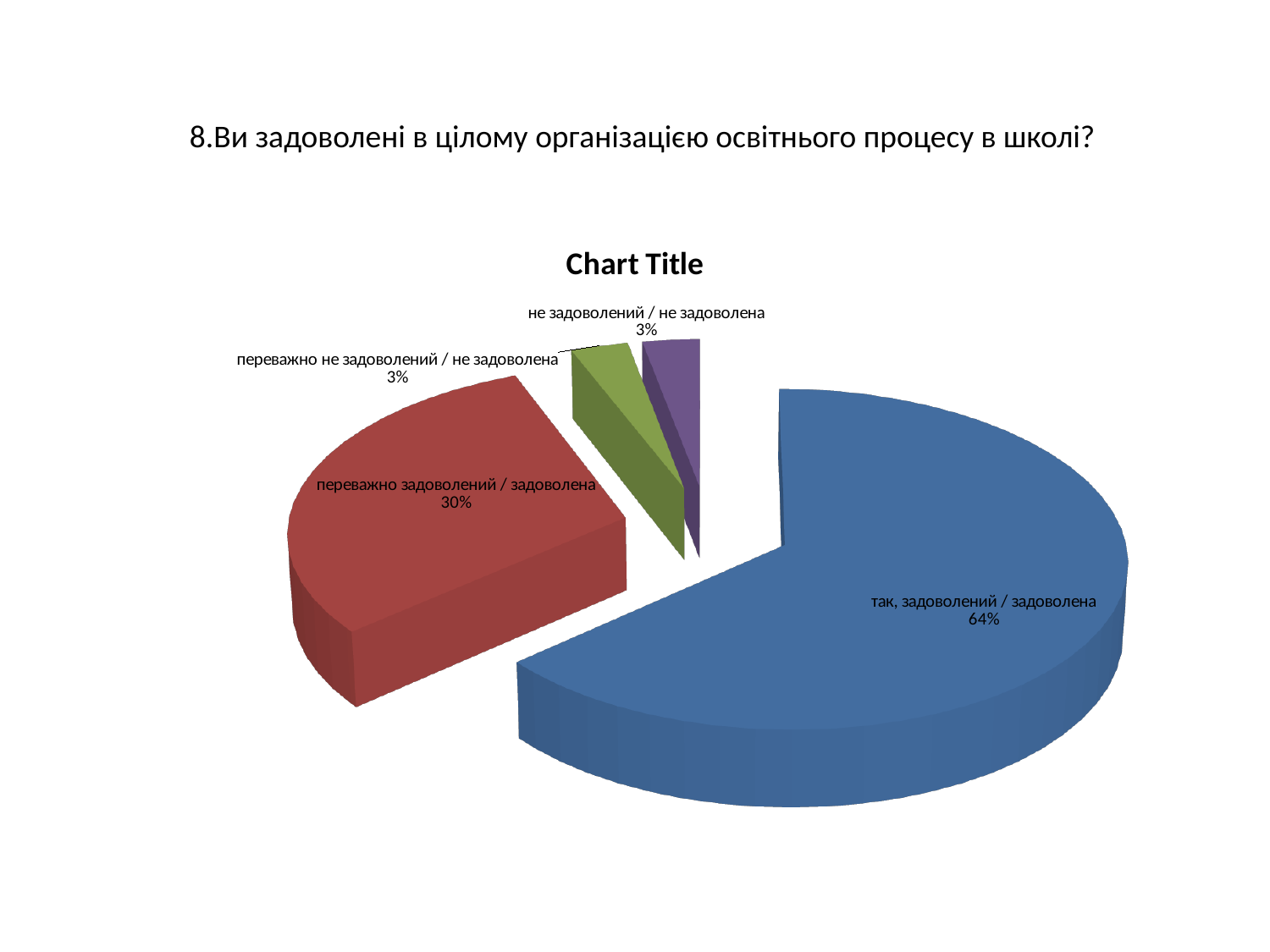
What is the title printed above the pie chart? Chart Title What is the difference in percentage points between "так, задоволений / задоволена" and "переважно задоволений / задоволена"? 34 Which category has the largest slice of the pie? так, задоволений / задоволена What colour is the slice for "так, задоволений / задоволена"? blue What kind of chart is shown on the slide? pie chart What share of the pie is labelled "переважно задоволений / задоволена"? 30% What percentage is shown for "переважно не задоволений / не задоволена"? 3% What percentage is shown for "не задоволений / не задоволена"? 3% What is the combined share of the two slices labelled 3%? 6% How many slices does the pie chart have? 4 Which is larger: the share for "переважно задоволений / задоволена" or the share for "не задоволений / не задоволена"? переважно задоволений / задоволена What percentage of respondents answered "так, задоволений / задоволена"? 64%